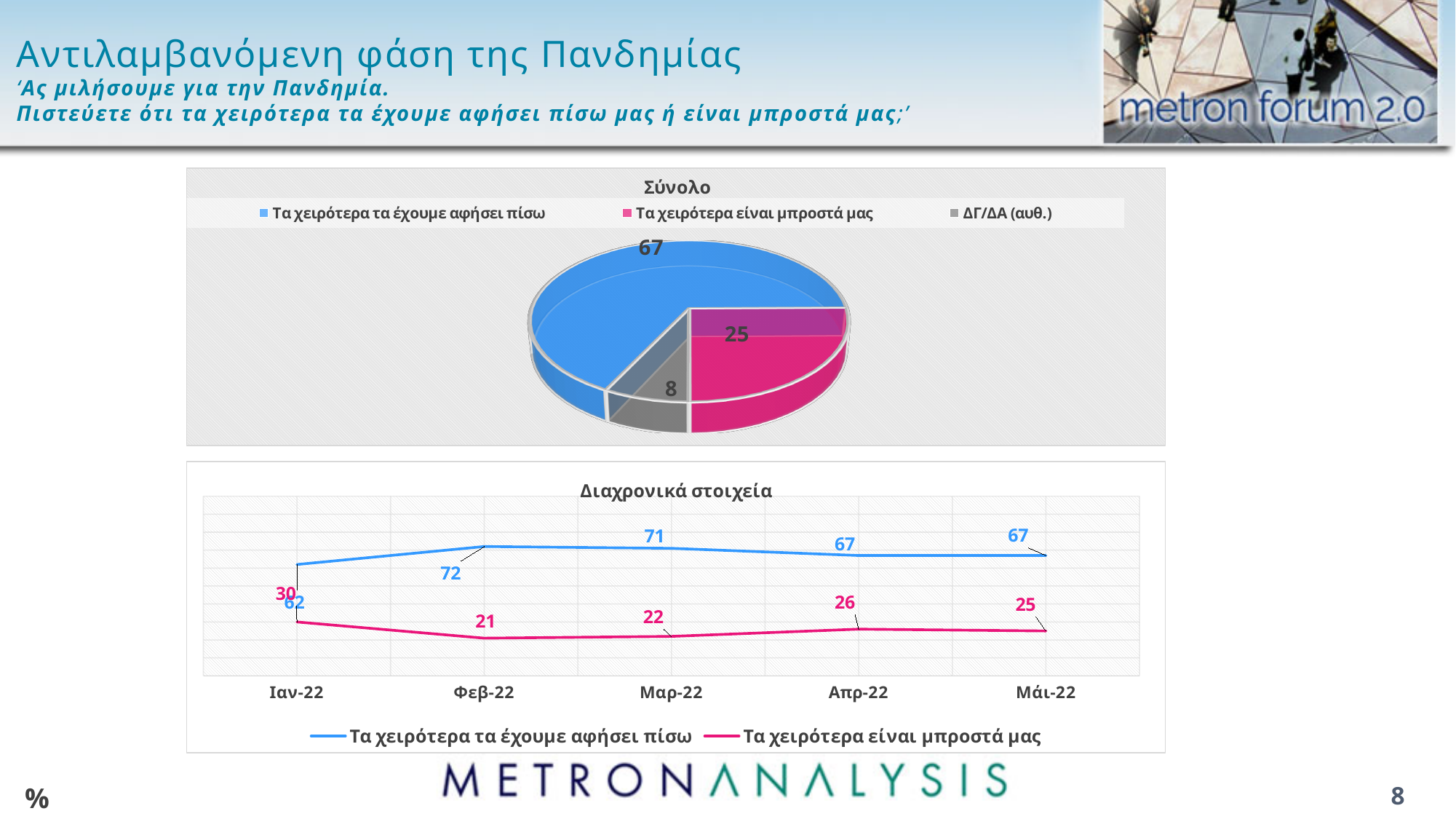
In the 'Διαχρονικά στοιχεία' chart, in which month is 'Τα χειρότερα είναι μπροστά μας' lowest? Φεβ-22 In the 'Σύνολο' chart, what is the value for 'ΔΓ/ΔΑ (αυθ.)'? 8 In the 'Διαχρονικά στοιχεία' chart, how many months are shown on the x axis? 5 In the 'Σύνολο' chart, what is the difference between 'Τα χειρότερα τα έχουμε αφήσει πίσω' and 'Τα χειρότερα είναι μπροστά μας'? 42 In the 'Διαχρονικά στοιχεία' chart, in which month is 'Τα χειρότερα τα έχουμε αφήσει πίσω' highest? Φεβ-22 What kind of chart is the 'Σύνολο' chart? pie chart How many series does the legend of the 'Διαχρονικά στοιχεία' chart list? 2 In the 'Σύνολο' chart, which category has the smallest slice? ΔΓ/ΔΑ (αυθ.) In the 'Διαχρονικά στοιχεία' chart, what is the difference between 'Τα χειρότερα τα έχουμε αφήσει πίσω' and 'Τα χειρότερα είναι μπροστά μας' in Μάι-22? 42 In the 'Σύνολο' chart, what is the value for 'Τα χειρότερα τα έχουμε αφήσει πίσω'? 67 In the 'Διαχρονικά στοιχεία' chart, what is the value for 'Τα χειρότερα τα έχουμε αφήσει πίσω' in Φεβ-22? 72 In the 'Διαχρονικά στοιχεία' chart, what is the value for 'Τα χειρότερα είναι μπροστά μας' in Ιαν-22? 30